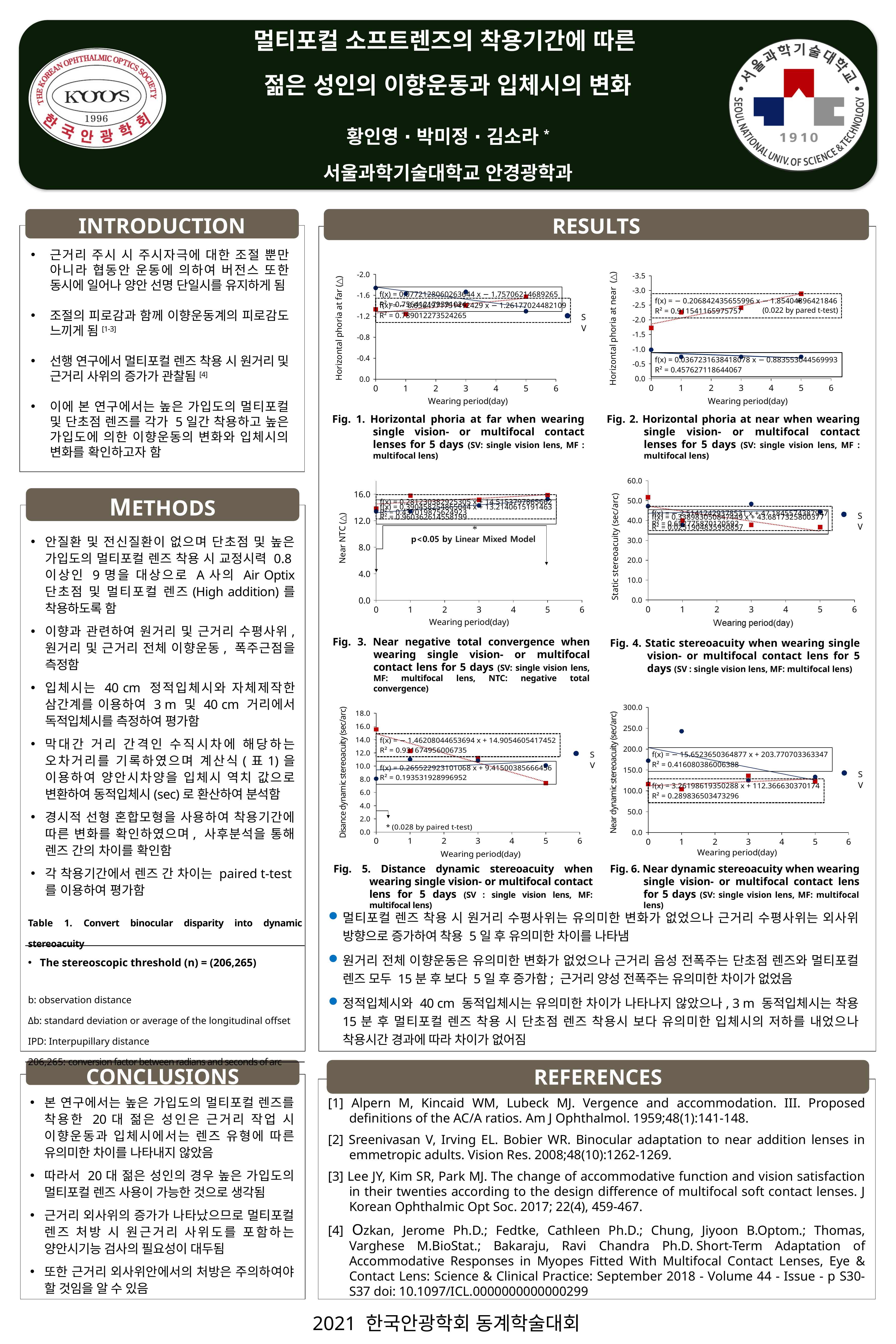
In Fig. 4 (Static stereoacuity), is the red-marker value at wearing period 5 days greater or less than 40.0? less In Fig. 4 (Static stereoacuity), is the red-marker value at wearing period 0 days greater or less than 40.0? greater In Fig. 3 (Near NTC), is the red-marker value at wearing period 1 day greater or less than 12.0? greater What kind of chart is Fig. 1 (Horizontal phoria at far)? scatter chart In Fig. 6 (Near dynamic stereoacuity), what is the R² value printed for the trendline f(x) = -15.6523650364877 x + 203.770703363347? 0.416080386006388 In Fig. 5 (Distance dynamic stereoacuity), do the red-marker values rise or fall as the wearing period increases? fall How many wearing-period time points are plotted on the x axis of Fig. 2 (Horizontal phoria at near)? 4 What is the label of the x axis in Fig. 4 (Static stereoacuity)? Wearing period(day)